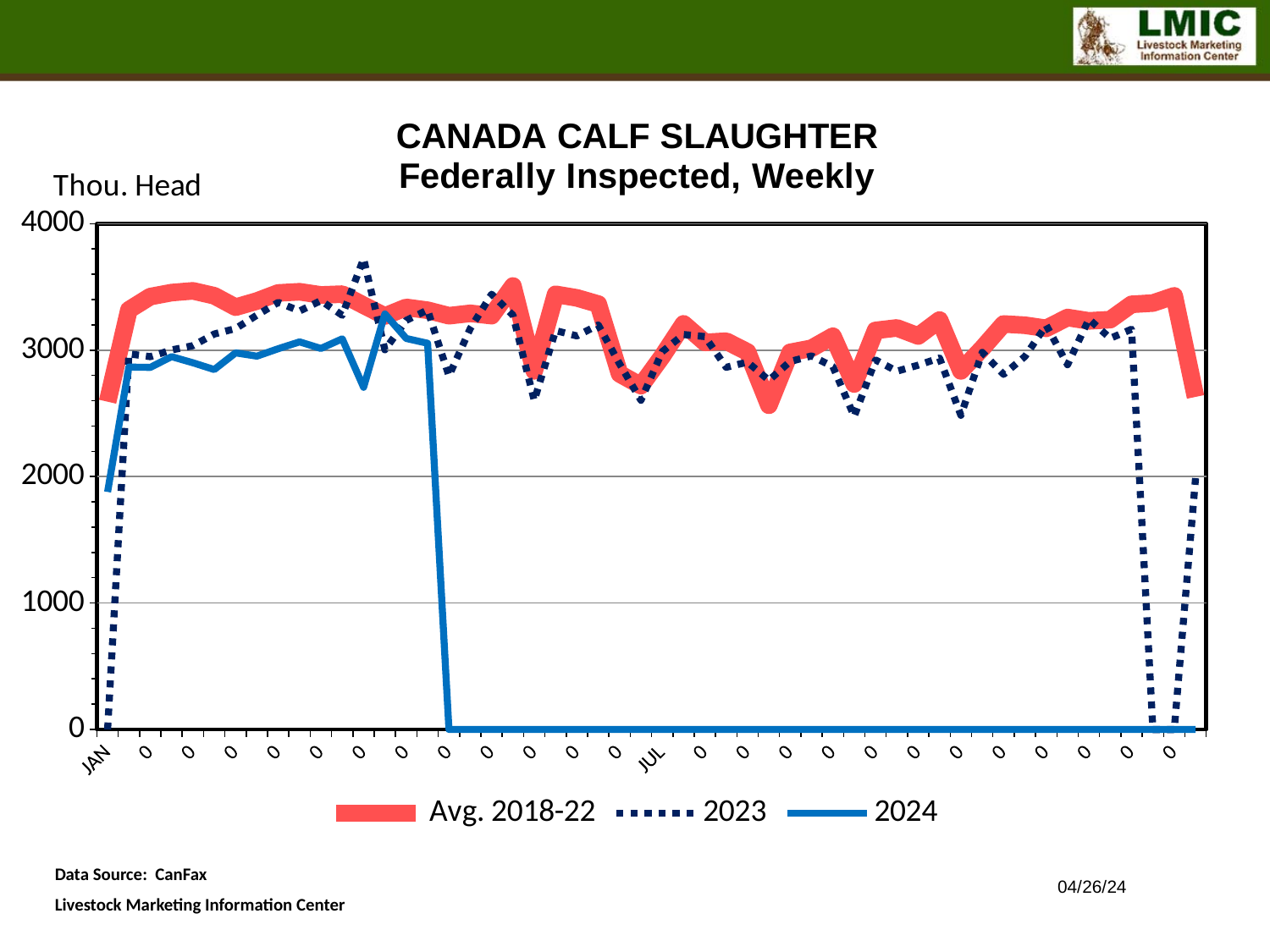
Is the Avg. 2018-22 value at JUL greater or less than 2000? greater At JUL, which series has the larger value, Avg. 2018-22 or 2024? Avg. 2018-22 What unit is shown on the vertical axis label? Thou. Head What is the title of the chart? CANADA CALF SLAUGHTER Federally Inspected, Weekly Is the 2024 value at JUL greater or less than 1000? less Is the Avg. 2018-22 value at JAN greater or less than 3000? less Does the 2024 line rise or fall between JAN and JUL? fall What kind of chart is shown on the slide? line chart At JAN, which series has the larger value, Avg. 2018-22 or 2023? Avg. 2018-22 How many series does the legend list? 3